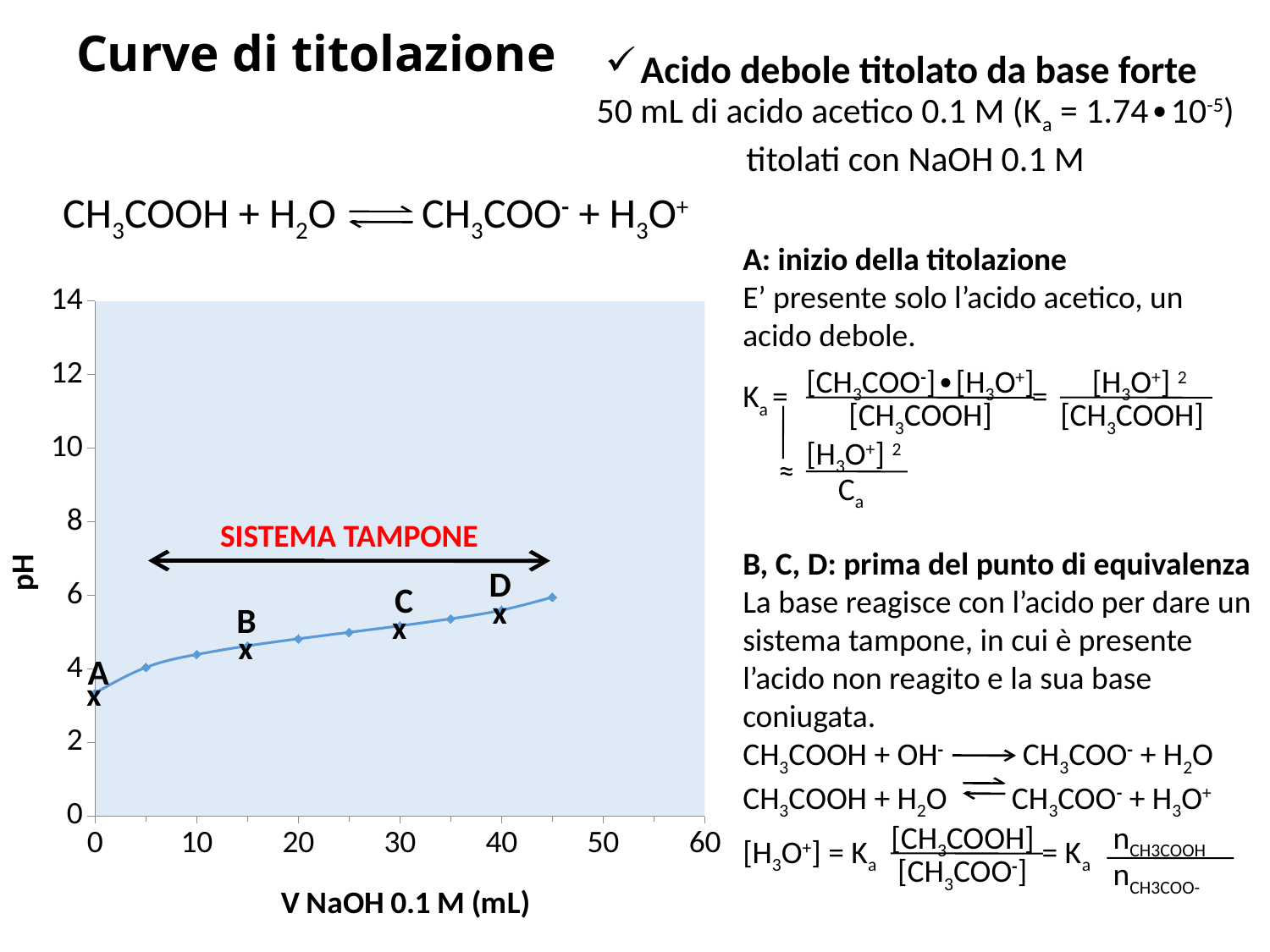
Is the pH at 0 mL of NaOH greater or less than 4? less How many data points are plotted on the curve? 10 Which has the higher pH, point A or point C? C What is the title of the x axis of the chart? V NaOH 0.1 M (mL) What kind of chart is shown on the slide? line chart Which of the labeled points A, B, C, D has the lowest pH? A Does the pH rise or fall as the volume of NaOH increases along the x axis? rise What is the title of the y axis of the chart? pH Is the pH at 15 mL of NaOH greater or less than 6? less Is the pH at 40 mL of NaOH greater or less than 4? greater Which of the labeled points A, B, C, D has the highest pH? D